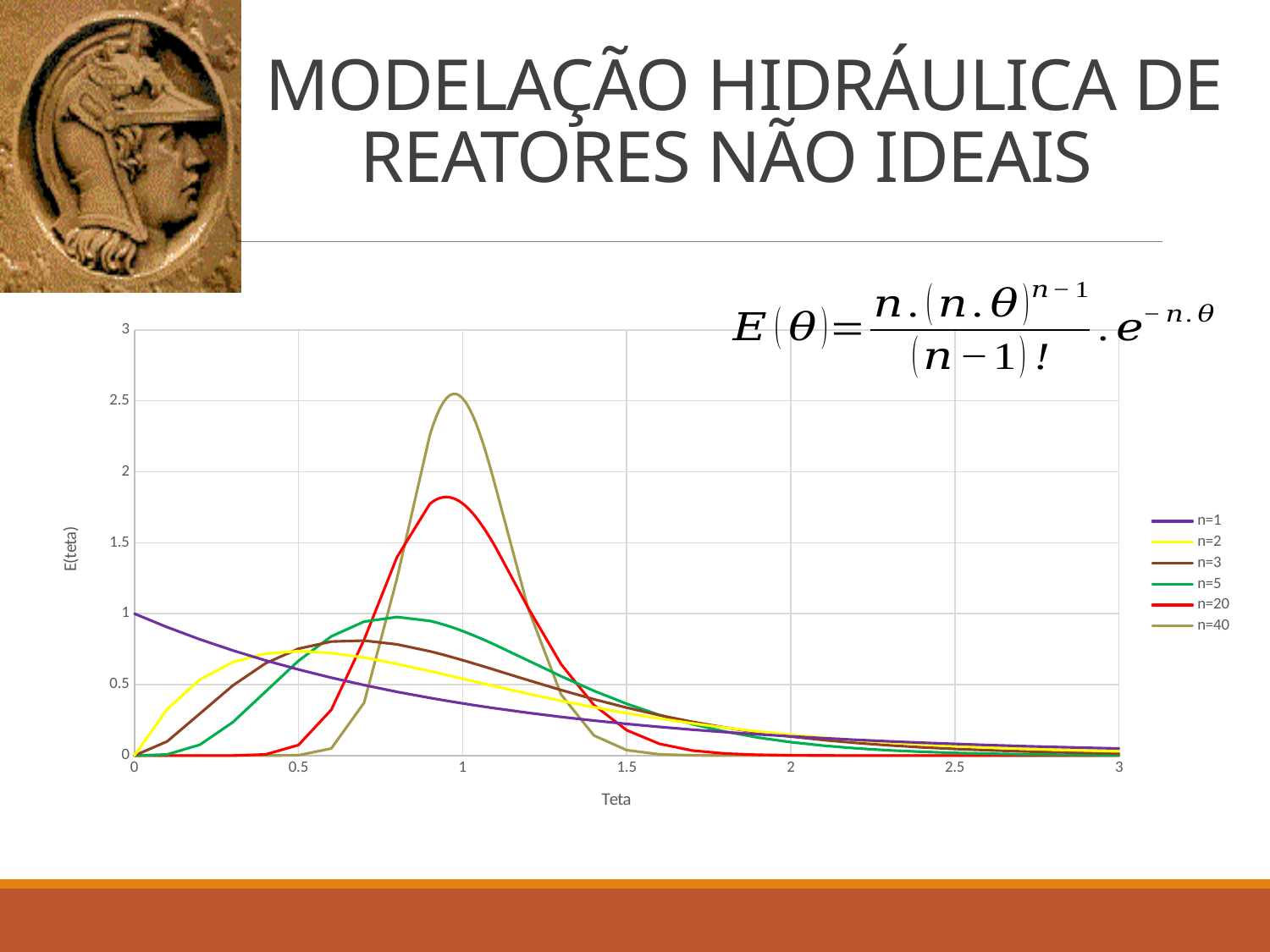
What is the title of the horizontal axis of the chart? Teta Does the n=1 series rise or fall as Teta increases from 0 to 3? fall What is the value of E(teta) for the n=1 series at Teta = 0? 1 Is the peak value of the n=20 series greater or less than 1.5? greater How many series does the chart legend list? 6 Which series reaches the highest peak value of E(teta)? n=40 Is the peak value of the n=20 series greater or less than 2? less What kind of chart is shown on the slide? line chart Is the peak value of the n=2 series greater or less than 1? less At Teta = 1, which series has the larger value, n=40 or n=1? n=40 What is the title of the vertical axis of the chart? E(teta)